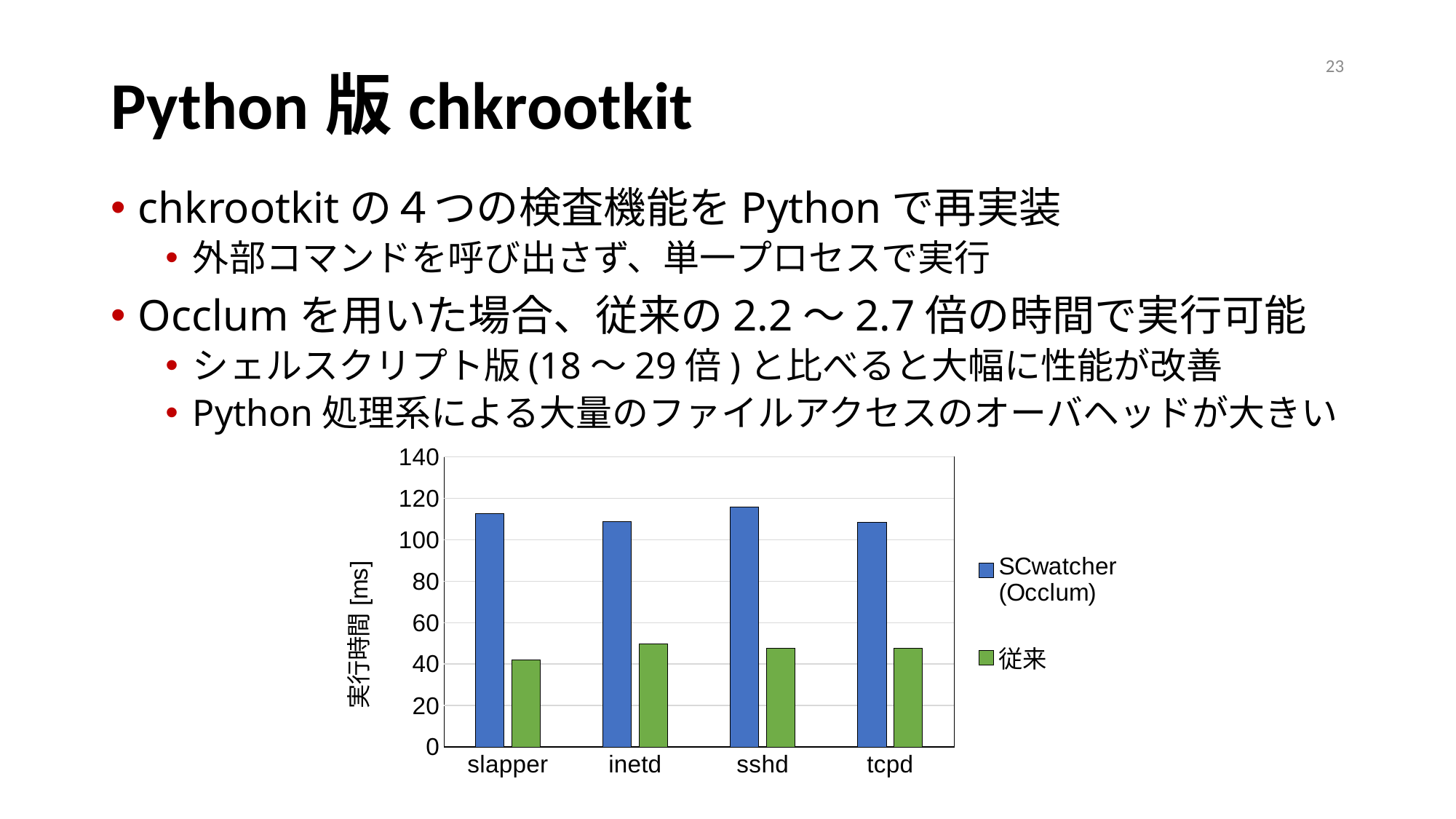
Is the 従来 value for inetd greater or less than 60? less For which category is the SCwatcher (Occlum) value highest? sshd How many categories are shown on the x axis of the chart? 4 What is the label of the chart's y axis? 実行時間 [ms] For sshd, which series has the larger value, SCwatcher (Occlum) or 従来? SCwatcher (Occlum) How many series does the chart's legend list? 2 Is the SCwatcher (Occlum) value for tcpd greater or less than 120? less Is the 従来 value for slapper greater or less than 20? greater What kind of chart is shown on the slide? bar chart What are the two series listed in the chart's legend? SCwatcher (Occlum) and 従来 For which category is the 従来 value lowest? slapper